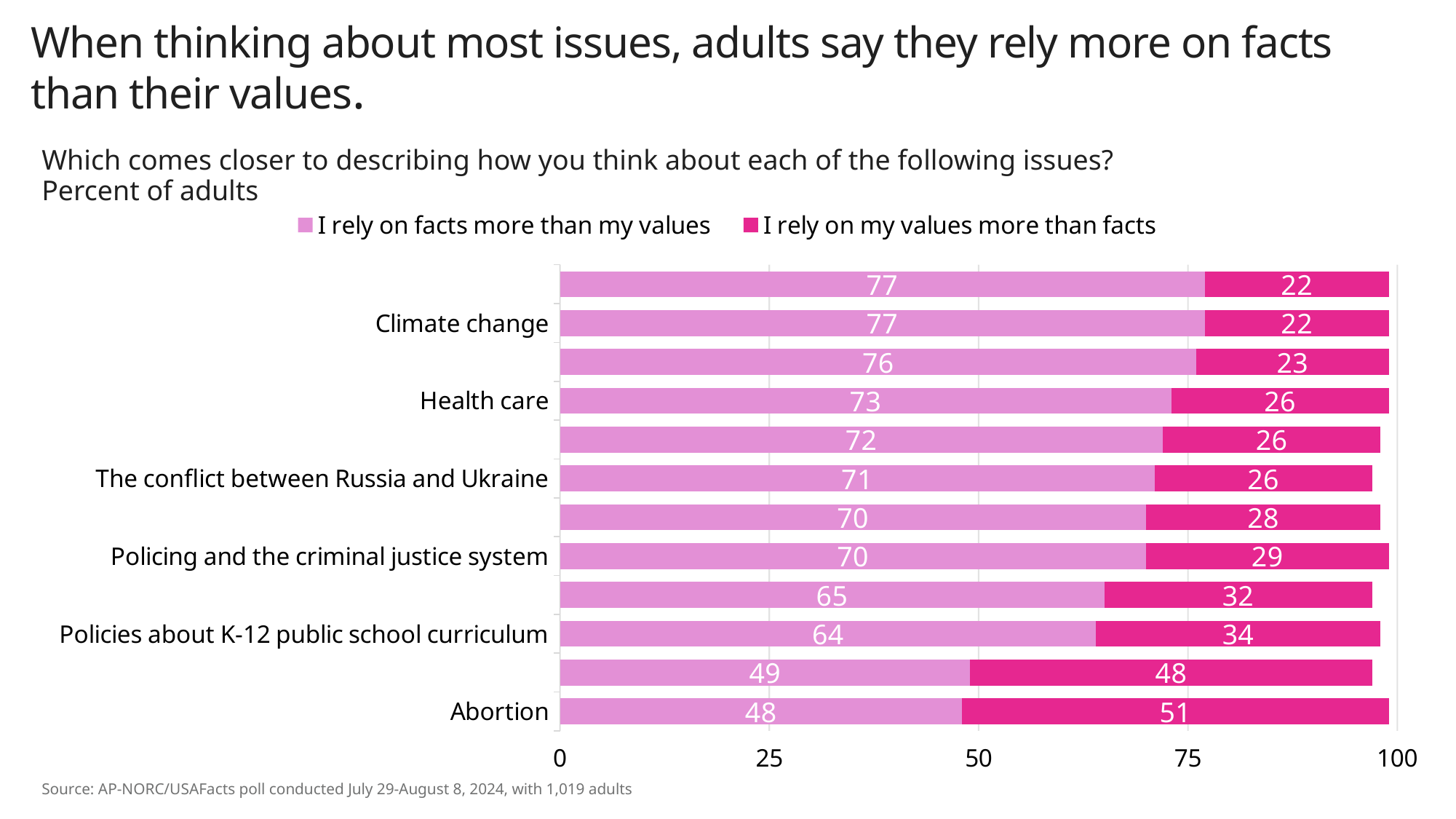
What percent of adults say they rely on facts more than their values for Policing and the criminal justice system? 70 What percent of adults say they rely on facts more than their values for Climate change? 77 Which is larger: the 'I rely on my values more than facts' percentage for Health care or for Policing and the criminal justice system? Policing and the criminal justice system How many series does the legend list? 2 What is the total of the two segments in the bar for The conflict between Russia and Ukraine? 97 What percent of adults say they rely on their values more than facts for Abortion? 51 What kind of chart is shown on the slide? Stacked bar chart What is the difference between the 'I rely on facts more than my values' percentages for Climate change and Abortion? 29 Among the labeled issues, which has the highest percent of adults relying on facts more than their values? Climate change What percent of adults say they rely on their values more than facts for Policies about K-12 public school curriculum? 34 Among the labeled issues, which has the lowest percent of adults relying on facts more than their values? Abortion What percent of adults say they rely on facts more than their values for Health care? 73